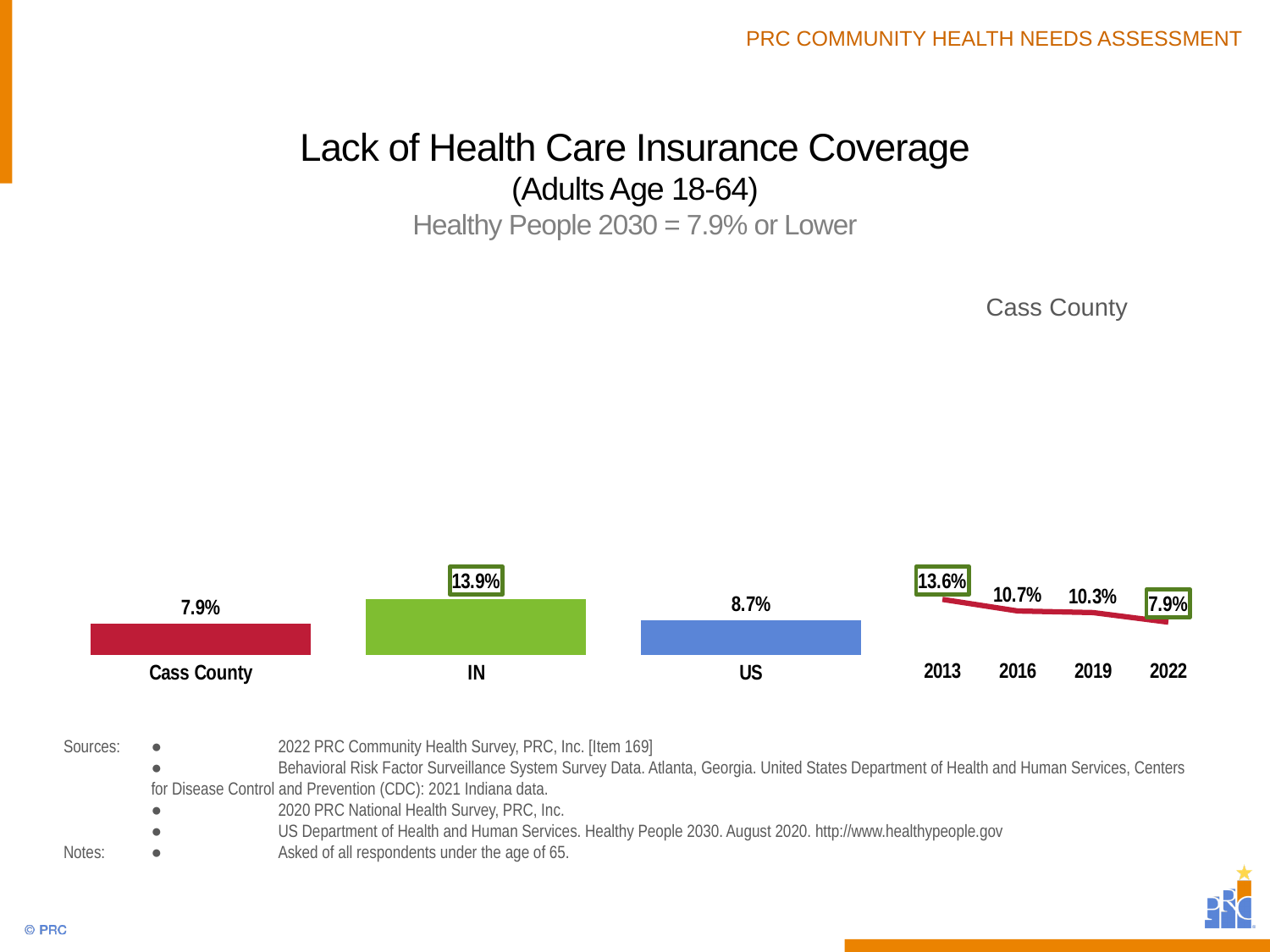
In the bar chart on the left, what is the difference between the IN value and the Cass County value? 6.0% In the bar chart on the left, which category has the lowest value? Cass County In the bar chart on the left, what is the value for IN? 13.9% In the Cass County trend chart on the right, what is the value for 2013? 13.6% In the bar chart on the left, what is the value for Cass County? 7.9% In the bar chart on the left, how many categories are shown? 3 In the bar chart on the left, what is the value for US? 8.7% In the bar chart on the left, which category has the highest value? IN In the Cass County trend chart on the right, what is the difference between the 2013 value and the 2022 value? 5.7% In the Cass County trend chart on the right, do the values rise or fall from 2013 to 2022? Fall What kind of chart is the chart on the left? Bar chart In the Cass County trend chart on the right, what is the value for 2016? 10.7%